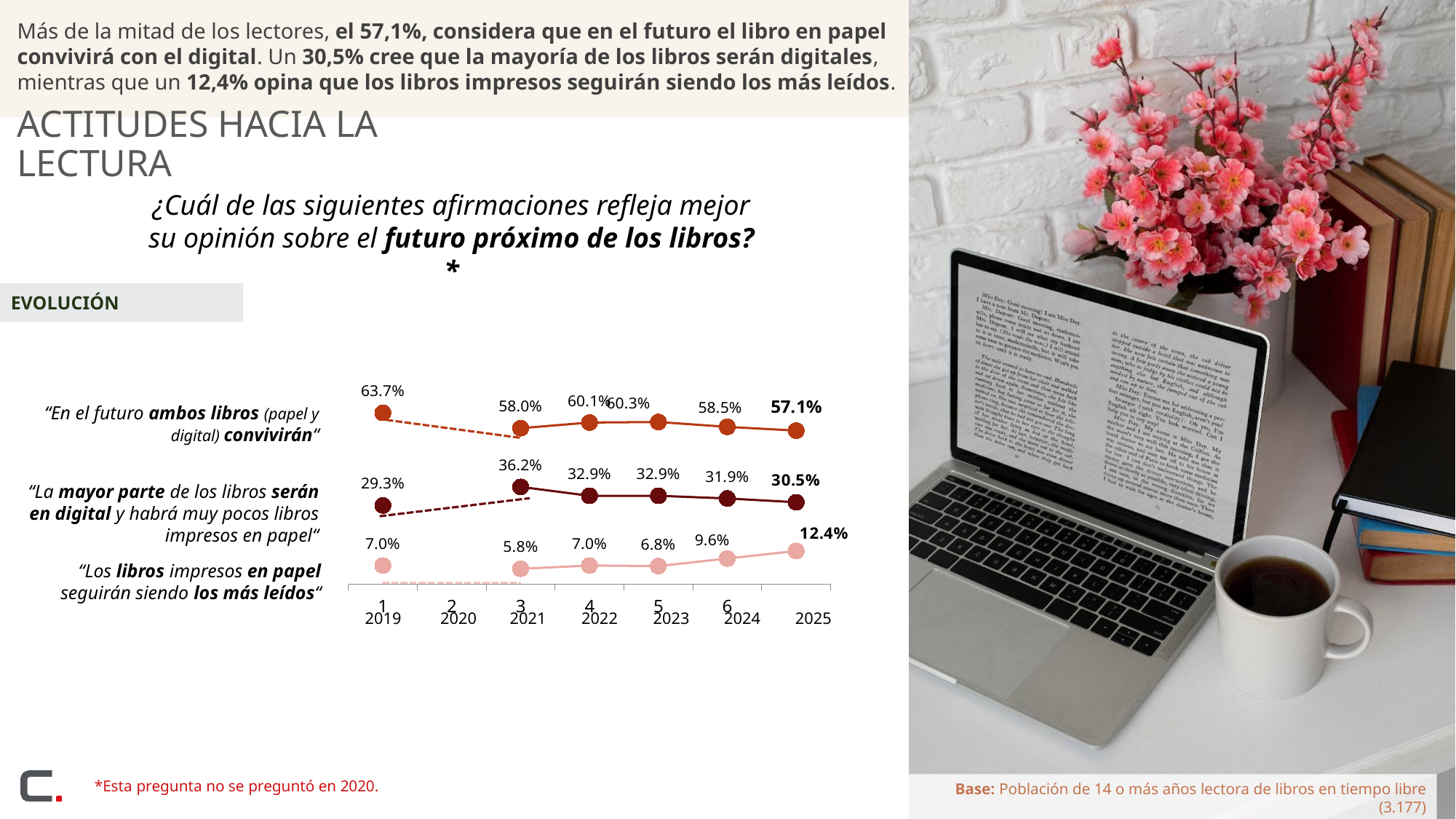
How many years have data points plotted for each series? 6 Which year on the x axis has no data points plotted? 2020 Which is larger in 2021: the value for "La mayor parte de los libros serán en digital" or the value for "Los libros impresos en papel seguirán siendo los más leídos"? La mayor parte de los libros serán en digital What is the difference between the 2019 and 2025 values for "En el futuro ambos libros convivirán"? 6.6 percentage points What is the 2025 value for "En el futuro ambos libros (papel y digital) convivirán"? 57.1% What kind of chart is shown in the EVOLUCIÓN section? Line chart In which year did "En el futuro ambos libros convivirán" reach its highest value? 2019 What is the 2024 value for "Los libros impresos en papel seguirán siendo los más leídos"? 9.6% How many series are plotted in the chart? 3 From 2021 to 2025, does the value for "Los libros impresos en papel seguirán siendo los más leídos" rise or fall? Rise What is the 2019 value for "La mayor parte de los libros serán en digital"? 29.3% In which year did "Los libros impresos en papel seguirán siendo los más leídos" have its lowest value? 2021